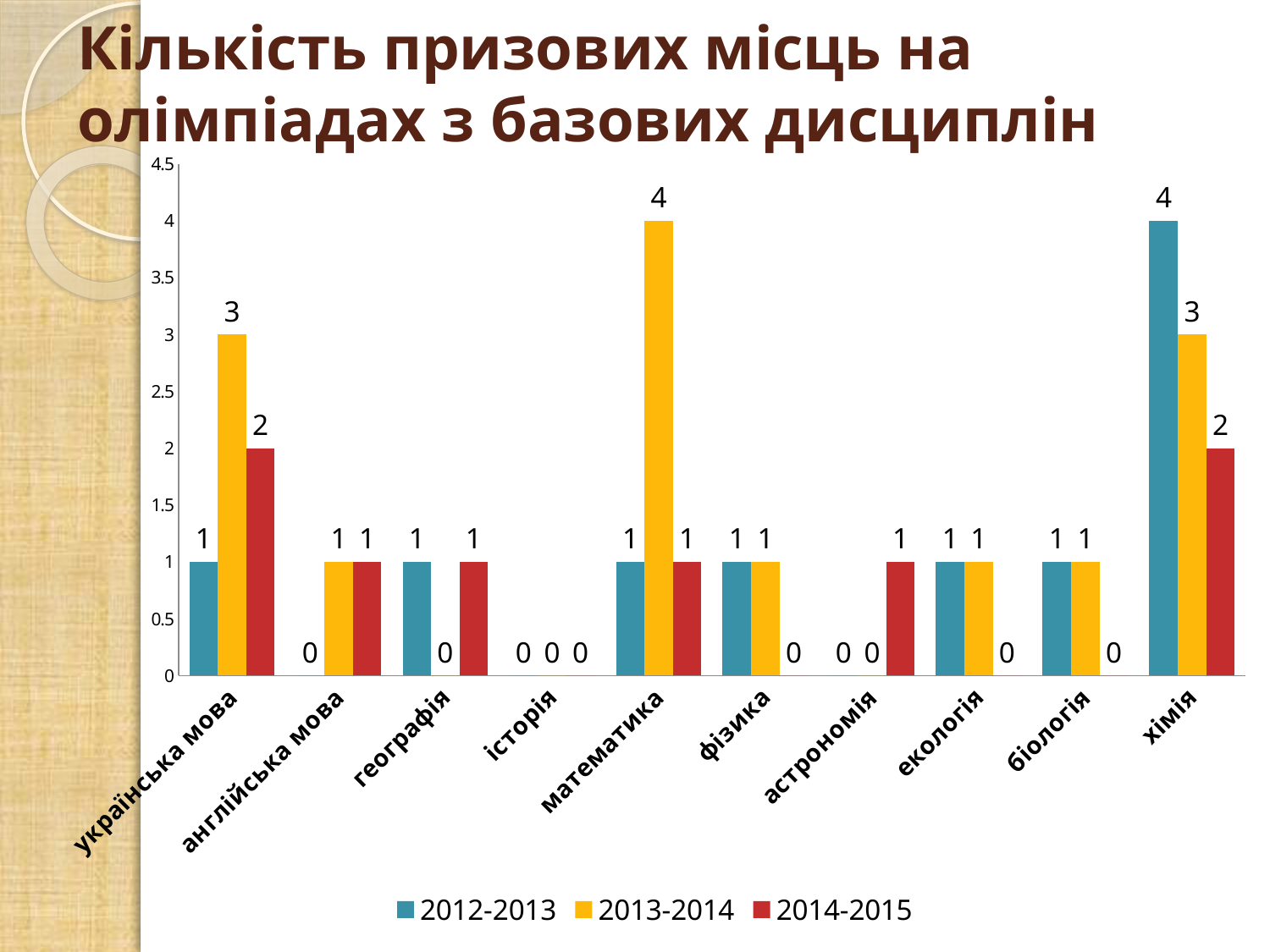
Which subject has the highest value in the 2012-2013 series? хімія Which subject has the highest value in the 2013-2014 series? математика Which subject has a value of 0 in all three series? історія What is the value for математика in the 2013-2014 series? 4 What is the difference between the 2013-2014 value for математика and the 2013-2014 value for українська мова? 1 Which is larger: the 2012-2013 value for хімія or the 2014-2015 value for хімія? 2012-2013 What is the value for українська мова in the 2014-2015 series? 2 What is the value for хімія in the 2012-2013 series? 4 What is the total of the three series values for хімія? 9 What type of chart is shown on the slide? bar chart How many series does the legend list? 3 How many subject categories are shown on the x axis? 10